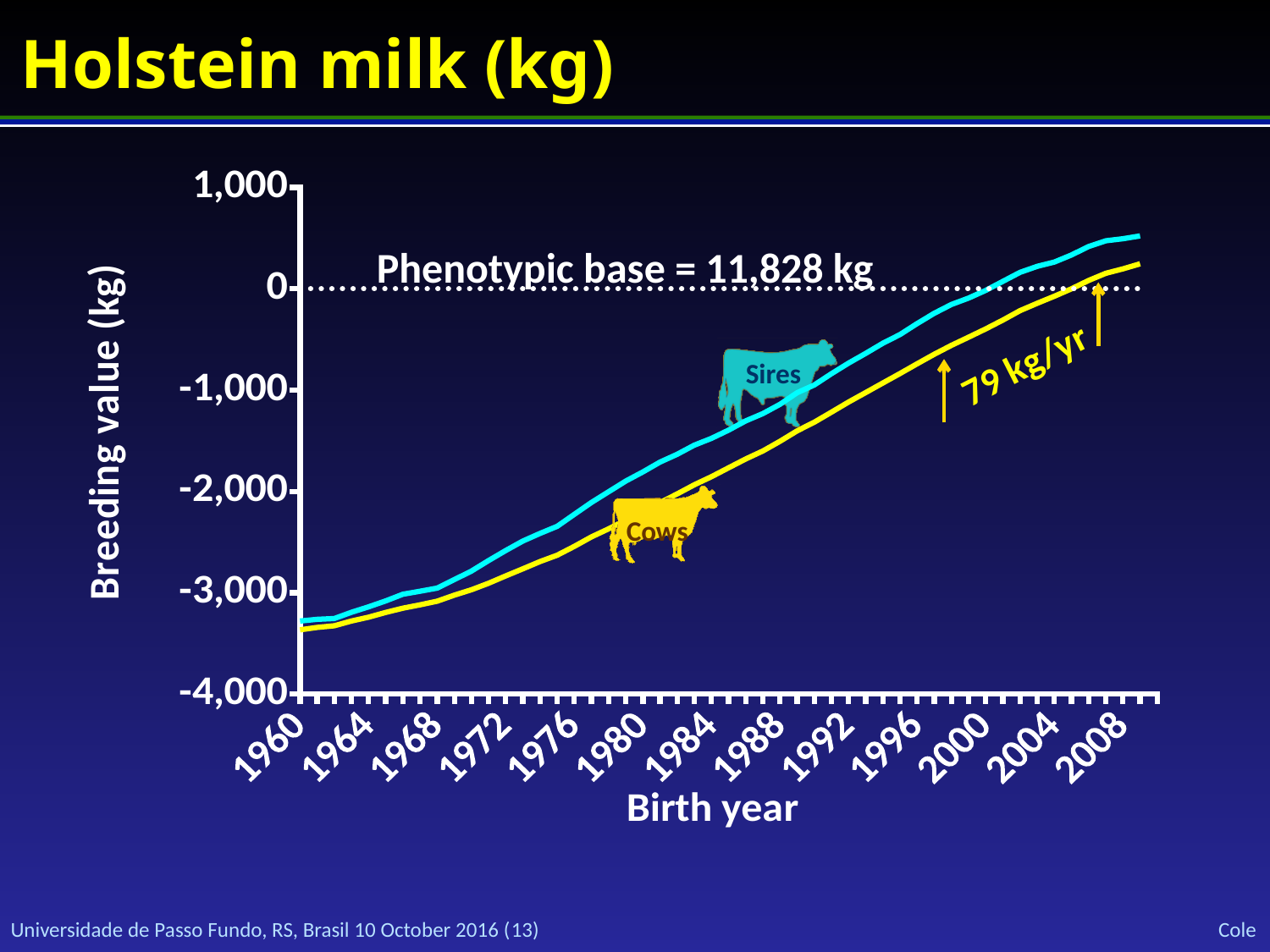
Do the breeding values for Sires rise or fall as birth year increases from 1960 to 2008? rise Is the breeding value for Sires in 1960 greater or less than -3,000? less What kind of chart is shown on the slide? line chart What is the title of the chart? Holstein milk (kg) How many series are plotted on the chart? 3 Which series has the lower breeding value in 1984, Sires or Cows? Cows Is the breeding value for Cows in 1960 greater or less than -3,000? less Is the breeding value for Cows in 1976 greater or less than -2,000? less Which series has the higher breeding value in 2008, Sires or Cows? Sires What are the names of the two series plotted on the chart? Sires and Cows